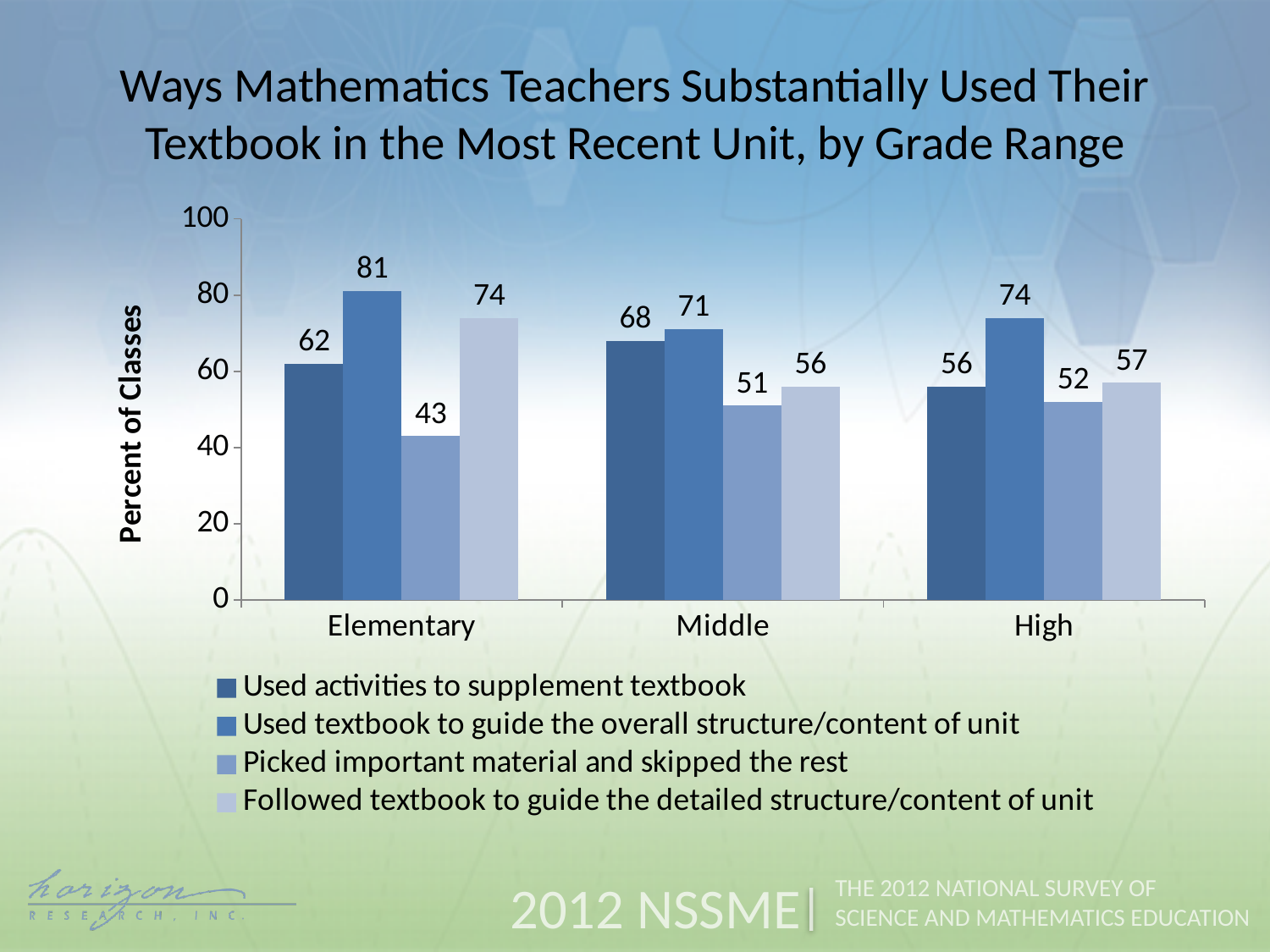
What is the label of the y axis? Percent of Classes What percent of Middle classes picked important material and skipped the rest? 51 What percent of High classes used activities to supplement textbook? 56 Which grade range has the lowest value for 'Picked important material and skipped the rest'? Elementary How many grade ranges are shown on the x axis? 3 What percent of Elementary classes used textbook to guide the overall structure/content of unit? 81 How many series does the legend list? 4 What is the difference between the Elementary and High values for 'Followed textbook to guide the detailed structure/content of unit'? 17 Which is larger for Middle classes: 'Used activities to supplement textbook' or 'Followed textbook to guide the detailed structure/content of unit'? Used activities to supplement textbook Does the value for 'Used textbook to guide the overall structure/content of unit' rise or fall from Elementary to High? Fall What kind of chart is shown on the slide? Bar chart Which grade range has the highest value for 'Used textbook to guide the overall structure/content of unit'? Elementary